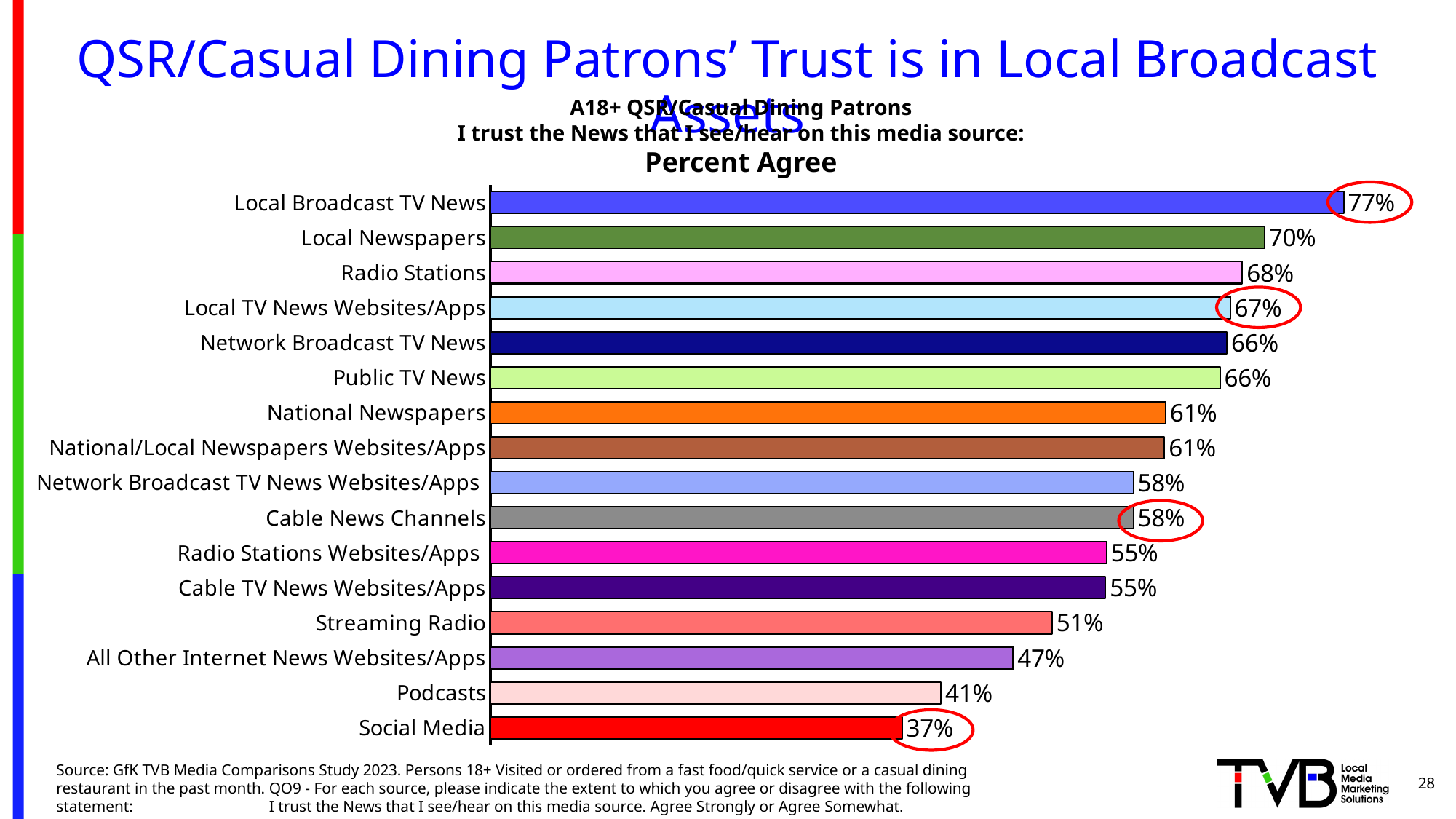
What is the difference in Percent Agree between Local Broadcast TV News and Social Media? 40 percentage points What is the difference in Percent Agree between Local Newspapers and Radio Stations? 2 percentage points What percent of QSR/Casual Dining patrons agree they trust the news on Local Broadcast TV News? 77% What is the Percent Agree value for Cable News Channels? 58% What is the Percent Agree value for Podcasts? 41% Which has a higher Percent Agree, Local TV News Websites/Apps or Cable TV News Websites/Apps? Local TV News Websites/Apps What colour is the bar for Social Media? Red What type of chart is shown on the slide? Bar chart Which media source has the highest Percent Agree? Local Broadcast TV News How many media sources are shown in the chart? 16 Which has a higher Percent Agree, Streaming Radio or All Other Internet News Websites/Apps? Streaming Radio Which media source has the lowest Percent Agree? Social Media